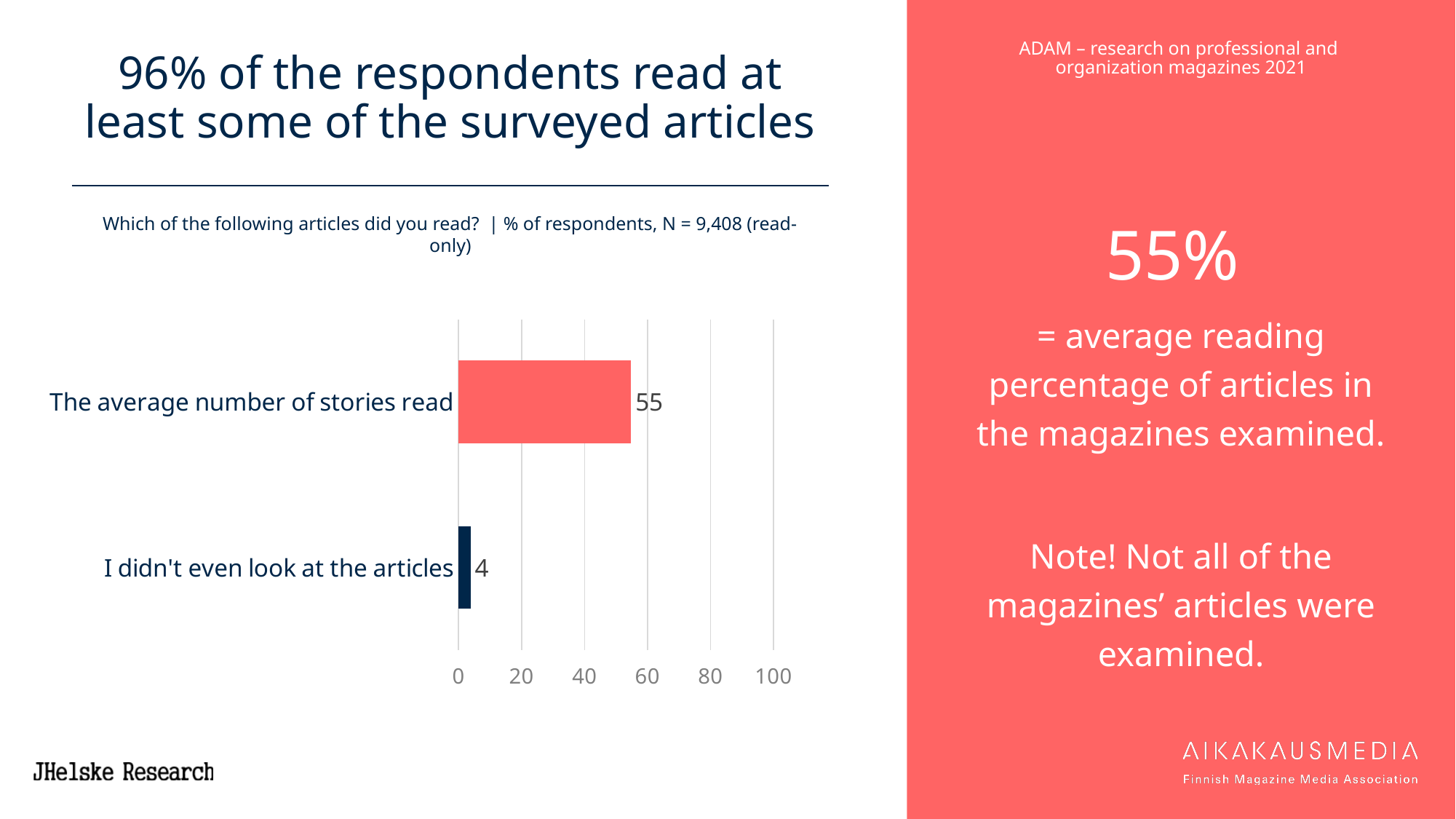
What kind of chart is shown on the slide? Bar chart What is the sample size (N) stated in the chart's subtitle? 9,408 What is the value for "The average number of stories read"? 55 What is the value for "I didn't even look at the articles"? 4 Is the value for "The average number of stories read" greater or less than 40? greater Which category has the lowest value? I didn't even look at the articles Which is larger: the value for "The average number of stories read" or the value for "I didn't even look at the articles"? The average number of stories read Is the value for "I didn't even look at the articles" greater or less than 20? less What is the highest tick value shown on the chart's axis? 100 How many categories are shown in the chart? 2 Which category has the highest value? The average number of stories read What is the difference between the value for "The average number of stories read" and the value for "I didn't even look at the articles"? 51